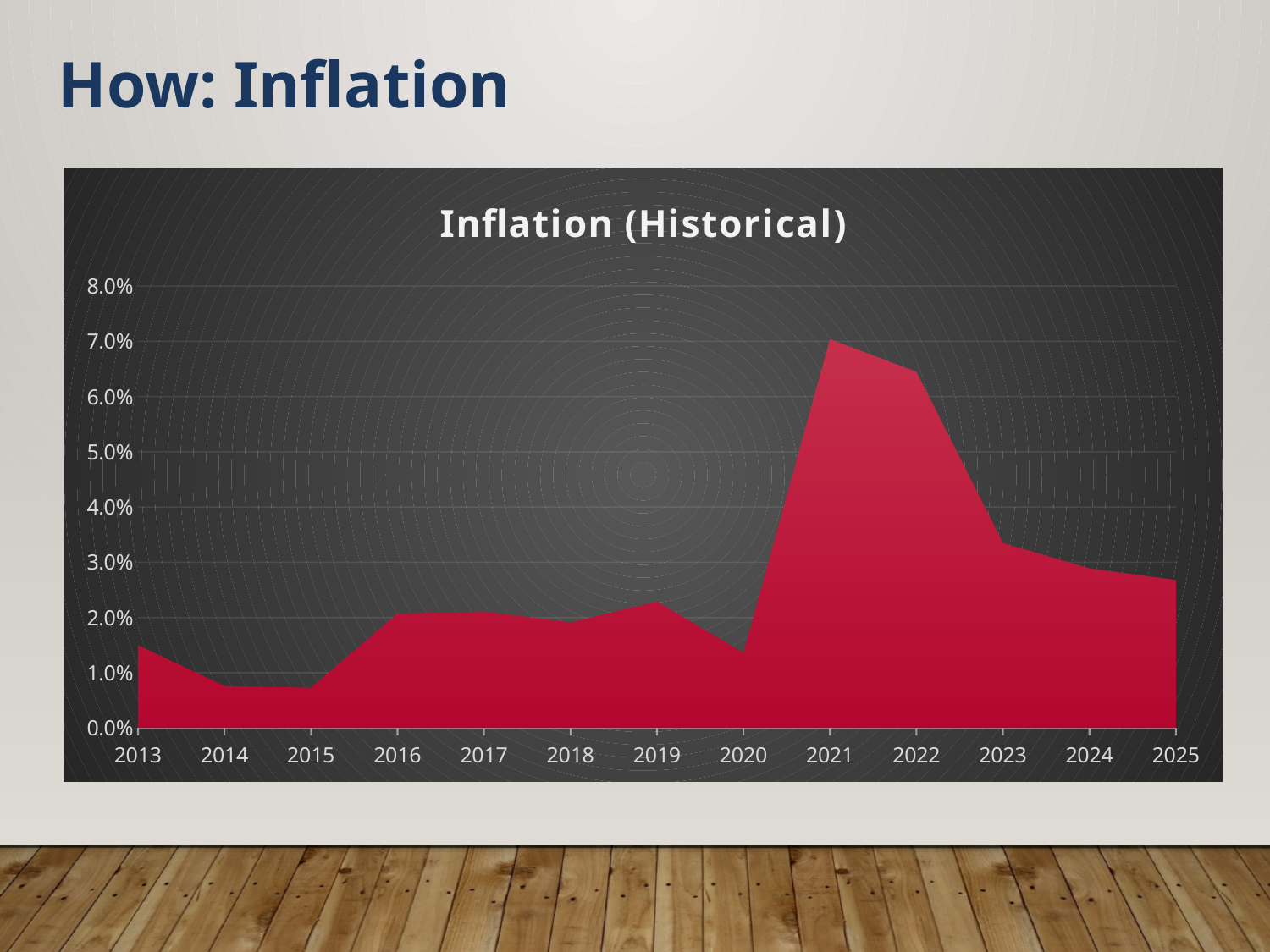
Is the value for 2020 greater or less than 2.0%? less Is the value for 2022 greater or less than 5.0%? greater What kind of chart is shown on the slide? area chart How many years are plotted along the x axis? 13 Which is larger, the value for 2021 or the value for 2022? 2021 Is the value for 2021 greater or less than 6.0%? greater Do the values rise or fall from 2021 to 2025? fall Which year has the highest inflation value? 2021 What is the title of the chart? Inflation (Historical) What is the highest value shown on the y axis? 8.0%